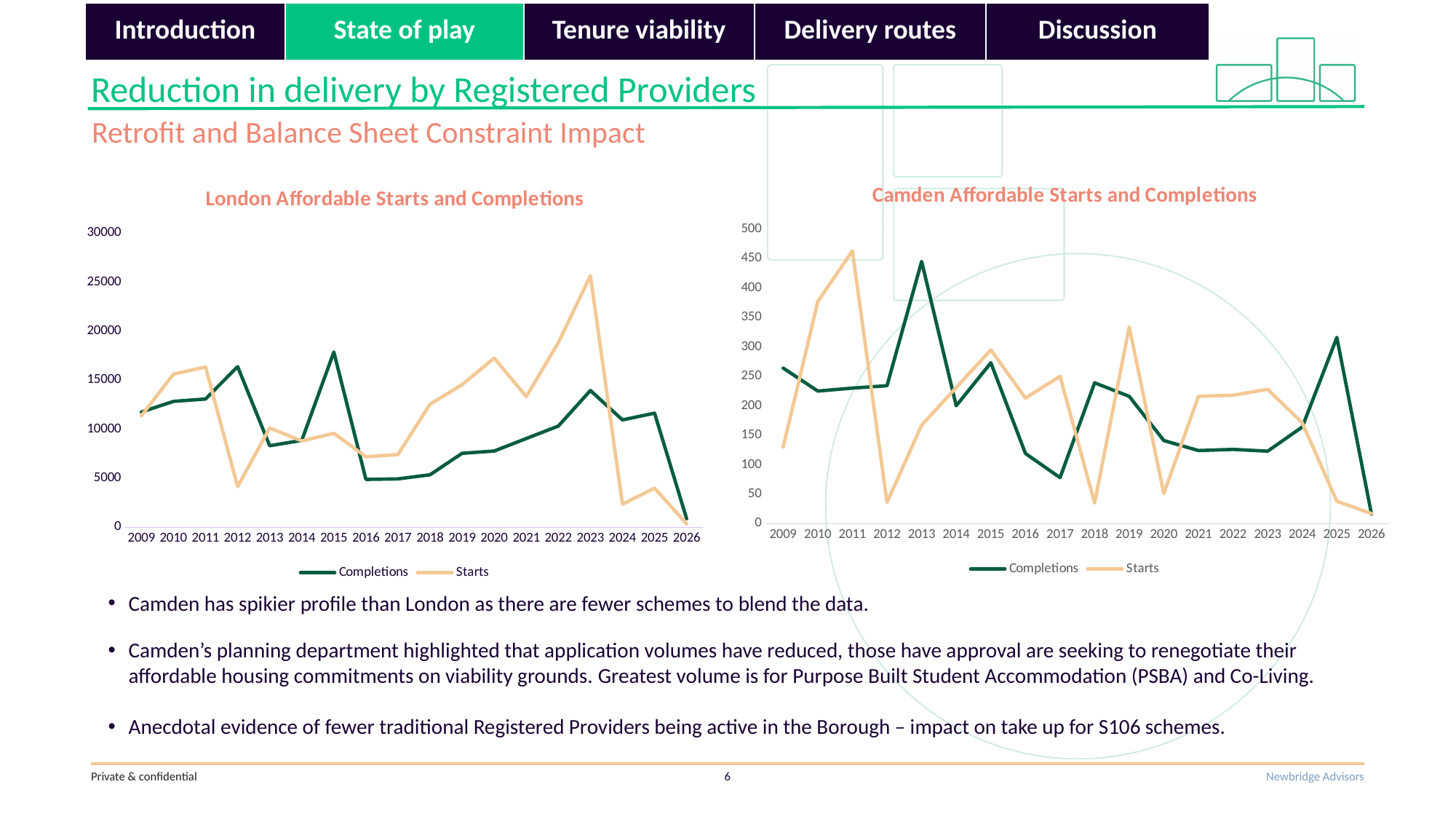
In the 'London Affordable Starts and Completions' chart, is the Starts value for 2023 greater or less than 20000? greater How many series does the legend of the 'Camden Affordable Starts and Completions' chart list? 2 In the 'London Affordable Starts and Completions' chart, in which year does the Completions series reach its highest value? 2015 In the 'Camden Affordable Starts and Completions' chart, which series has the higher value in 2013, Completions or Starts? Completions In the 'Camden Affordable Starts and Completions' chart, in which year does the Completions series reach its highest value? 2013 In the 'Camden Affordable Starts and Completions' chart, in which year does the Starts series reach its highest value? 2011 In the 'London Affordable Starts and Completions' chart, is the Starts value for 2012 greater or less than 5000? less What type of chart is the 'London Affordable Starts and Completions' chart? line chart In the 'London Affordable Starts and Completions' chart, which series has the higher value in 2015, Completions or Starts? Completions In the 'Camden Affordable Starts and Completions' chart, is the Starts value for 2011 greater or less than 400? greater How many years are shown on the x axis of the 'London Affordable Starts and Completions' chart? 18